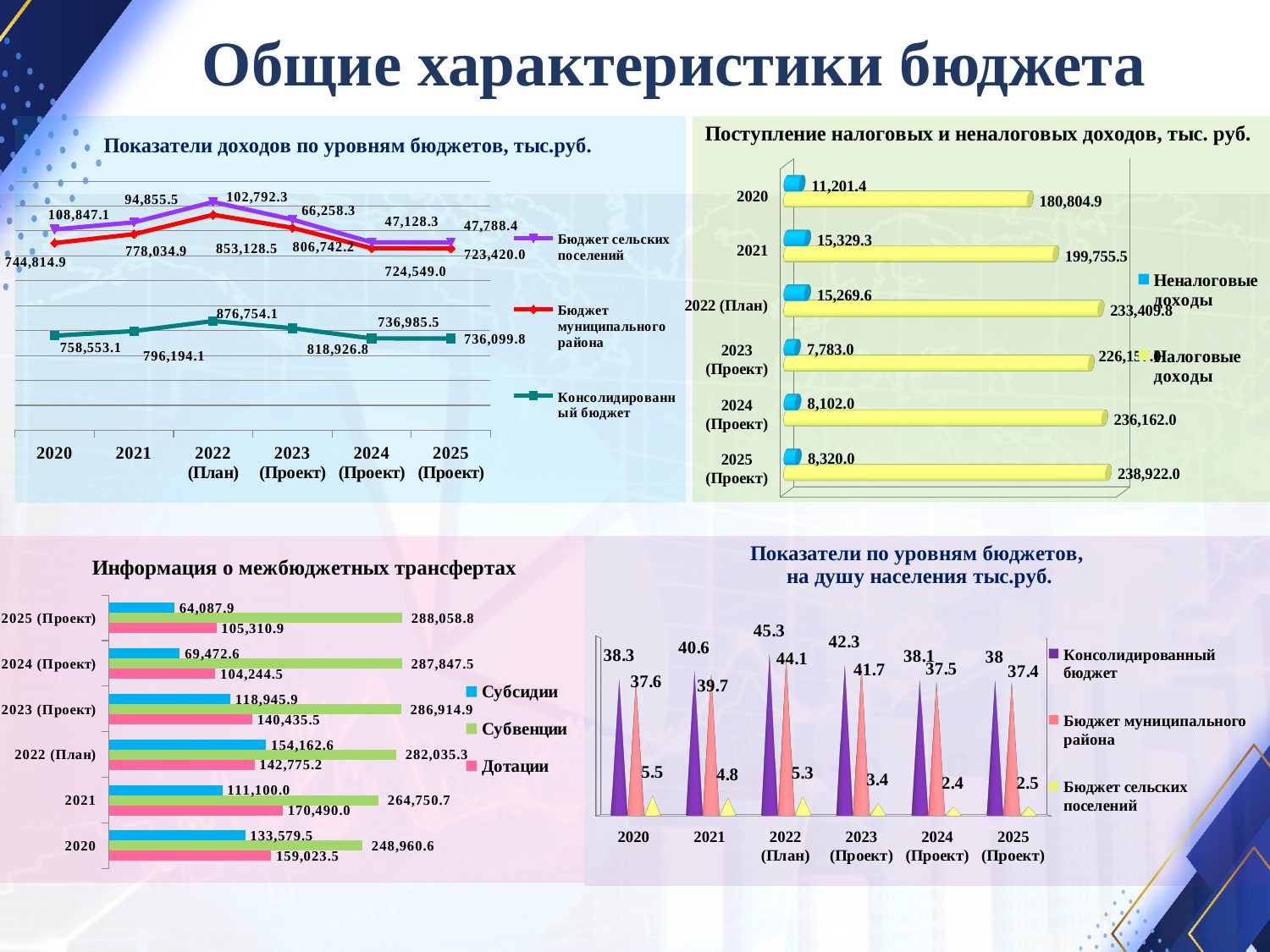
How many series does the legend of the chart 'Информация о межбюджетных трансфертах' list? 3 In the chart 'Информация о межбюджетных трансфертах', which year has the lowest value of Субсидии? 2025 (Проект) In the chart 'Поступление налоговых и неналоговых доходов, тыс. руб.', what is the value of Налоговые доходы for 2025 (Проект)? 238,922.0 In the chart 'Информация о межбюджетных трансфертах', what is the value of Субвенции for 2022 (План)? 282,035.3 In the chart 'Поступление налоговых и неналоговых доходов, тыс. руб.', what is the difference between Неналоговые доходы in 2021 and in 2020? 4,127.9 In the chart 'Показатели доходов по уровням бюджетов, тыс.руб.', what is the value of Консолидированный бюджет for 2022 (План)? 876,754.1 In the chart 'Показатели по уровням бюджетов, на душу населения тыс.руб.', what is the value of Консолидированный бюджет for 2022 (План)? 45.3 What type of chart is 'Показатели доходов по уровням бюджетов, тыс.руб.'? Line chart In the chart 'Показатели доходов по уровням бюджетов, тыс.руб.', which year has the lowest value of Бюджет сельских поселений? 2024 (Проект) In the chart 'Поступление налоговых и неналоговых доходов, тыс. руб.', which year has the highest value of Неналоговые доходы? 2021 How many year categories are shown on the x axis of the chart 'Показатели по уровням бюджетов, на душу населения тыс.руб.'? 6 In the chart 'Информация о межбюджетных трансфертах', which is larger for 2021: Субсидии or Дотации? Дотации